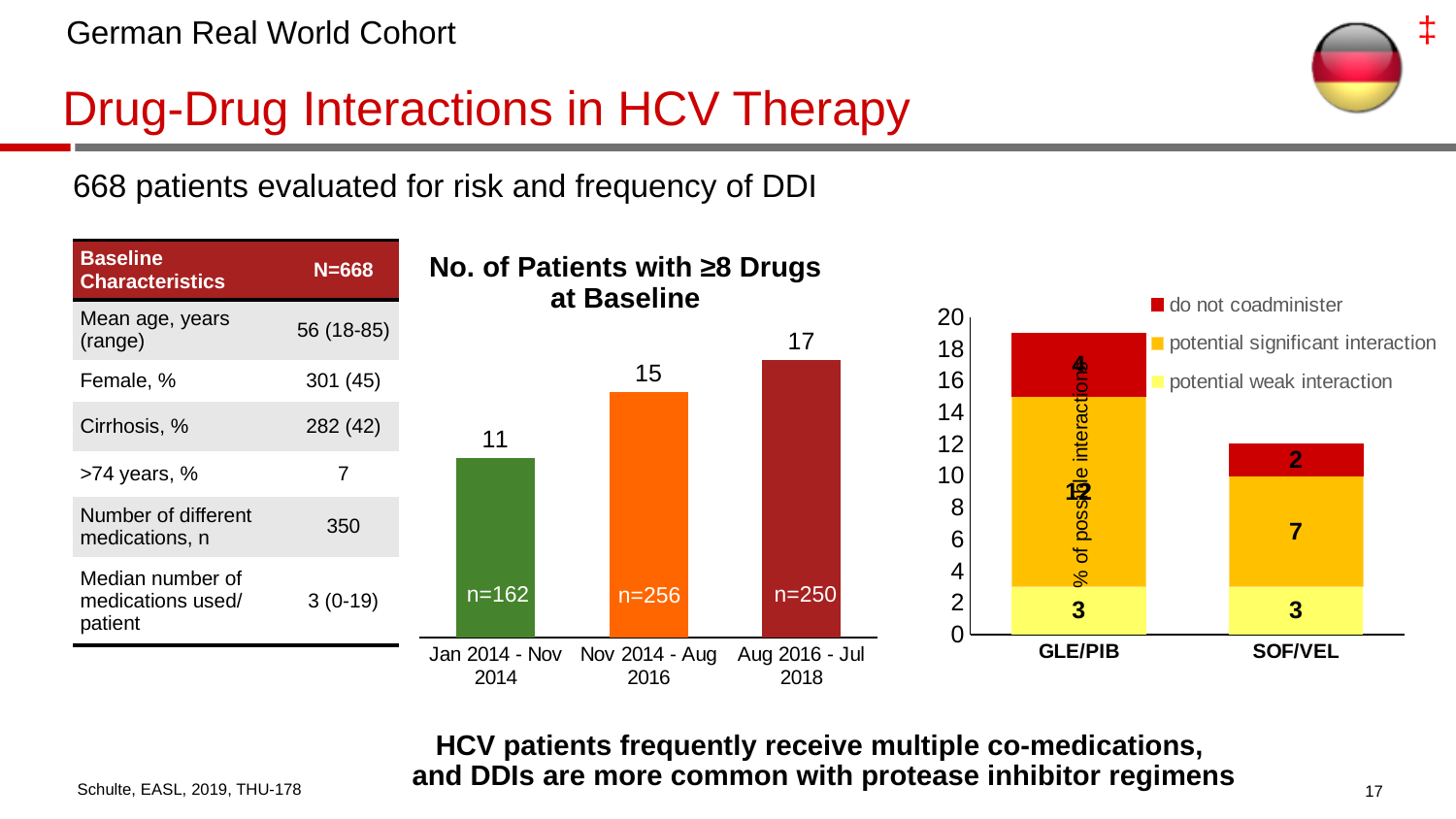
On the 'No. of Patients with ≥8 Drugs at Baseline' chart, which period has the highest value? Aug 2016 - Jul 2018 On the 'No. of Patients with ≥8 Drugs at Baseline' chart, what is the value for Aug 2016 - Jul 2018? 17 On the 'No. of Patients with ≥8 Drugs at Baseline' chart, what is the difference between the Nov 2014 - Aug 2016 value and the Jan 2014 - Nov 2014 value? 4 On the stacked bar chart on the right, is the total for GLE/PIB greater or less than 16? greater On the 'No. of Patients with ≥8 Drugs at Baseline' chart, how many periods are plotted? 3 On the 'No. of Patients with ≥8 Drugs at Baseline' chart, what is the n shown inside the Nov 2014 - Aug 2016 bar? n=256 On the stacked bar chart on the right, what is the total of the SOF/VEL bar? 12 On the 'No. of Patients with ≥8 Drugs at Baseline' chart, which period has the lowest value? Jan 2014 - Nov 2014 On the stacked bar chart on the right, what is the 'potential significant interaction' value for SOF/VEL? 7 On the 'No. of Patients with ≥8 Drugs at Baseline' chart, do the values rise or fall from left to right along the x axis? rise On the 'No. of Patients with ≥8 Drugs at Baseline' chart, what is the value for Jan 2014 - Nov 2014? 11 On the stacked bar chart on the right, how many series does the legend list? 3